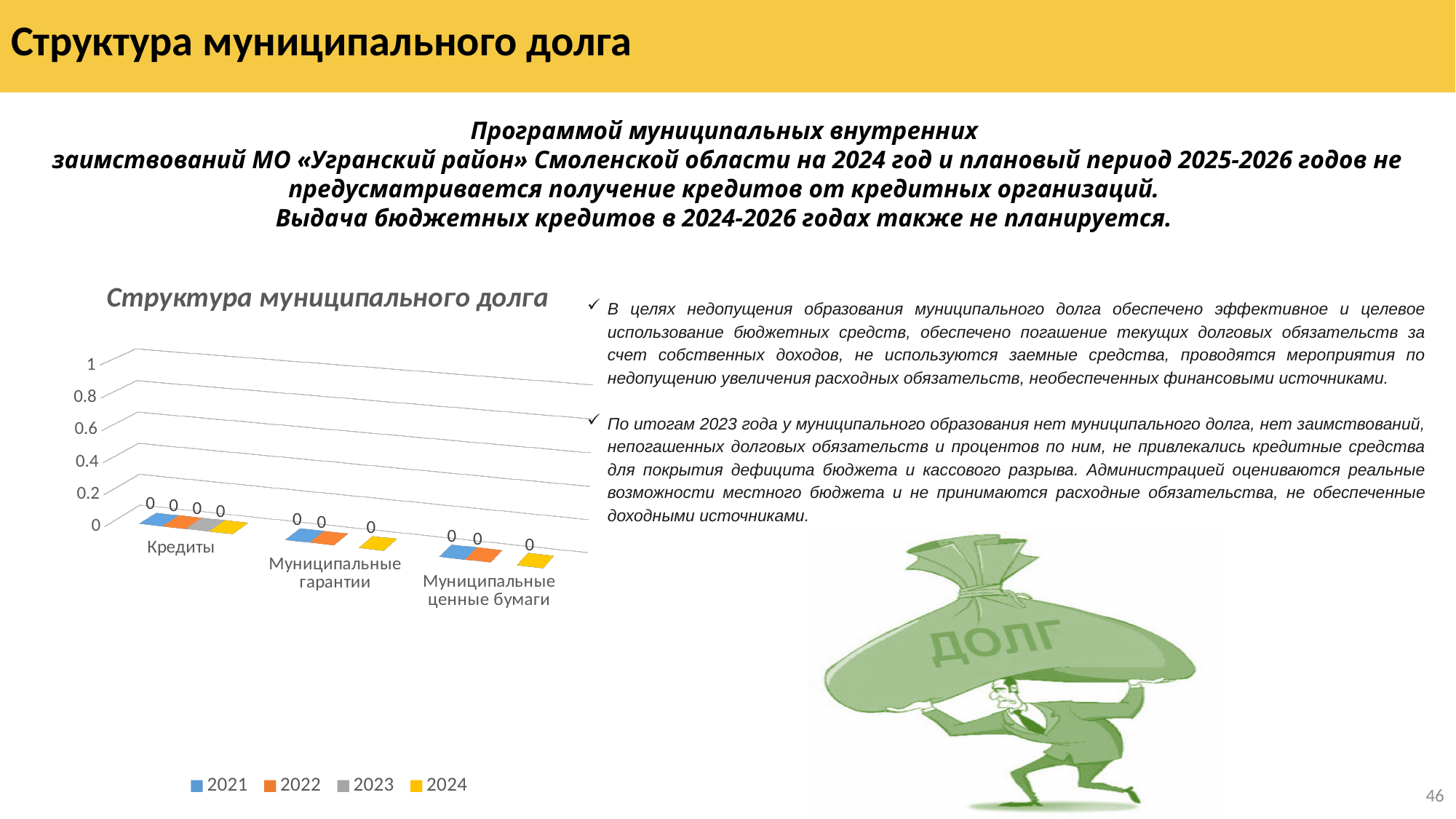
What is the highest tick value shown on the vertical axis of the chart? 1 What is the value for Кредиты in 2021? 0 Which series are listed in the chart legend? 2021, 2022, 2023, 2024 What is the value for Кредиты in 2024? 0 What kind of chart is shown on the slide? bar chart What is the title of the chart on the slide? Структура муниципального долга Is the value for Муниципальные гарантии in 2024 greater or less than 0.2? less How many series does the chart legend list? 4 How many categories are shown on the x axis of the chart? 3 What is the difference between the 2021 and 2024 values for Кредиты? 0 What is the value for Муниципальные гарантии in 2022? 0 What is the value for Муниципальные ценные бумаги in 2024? 0